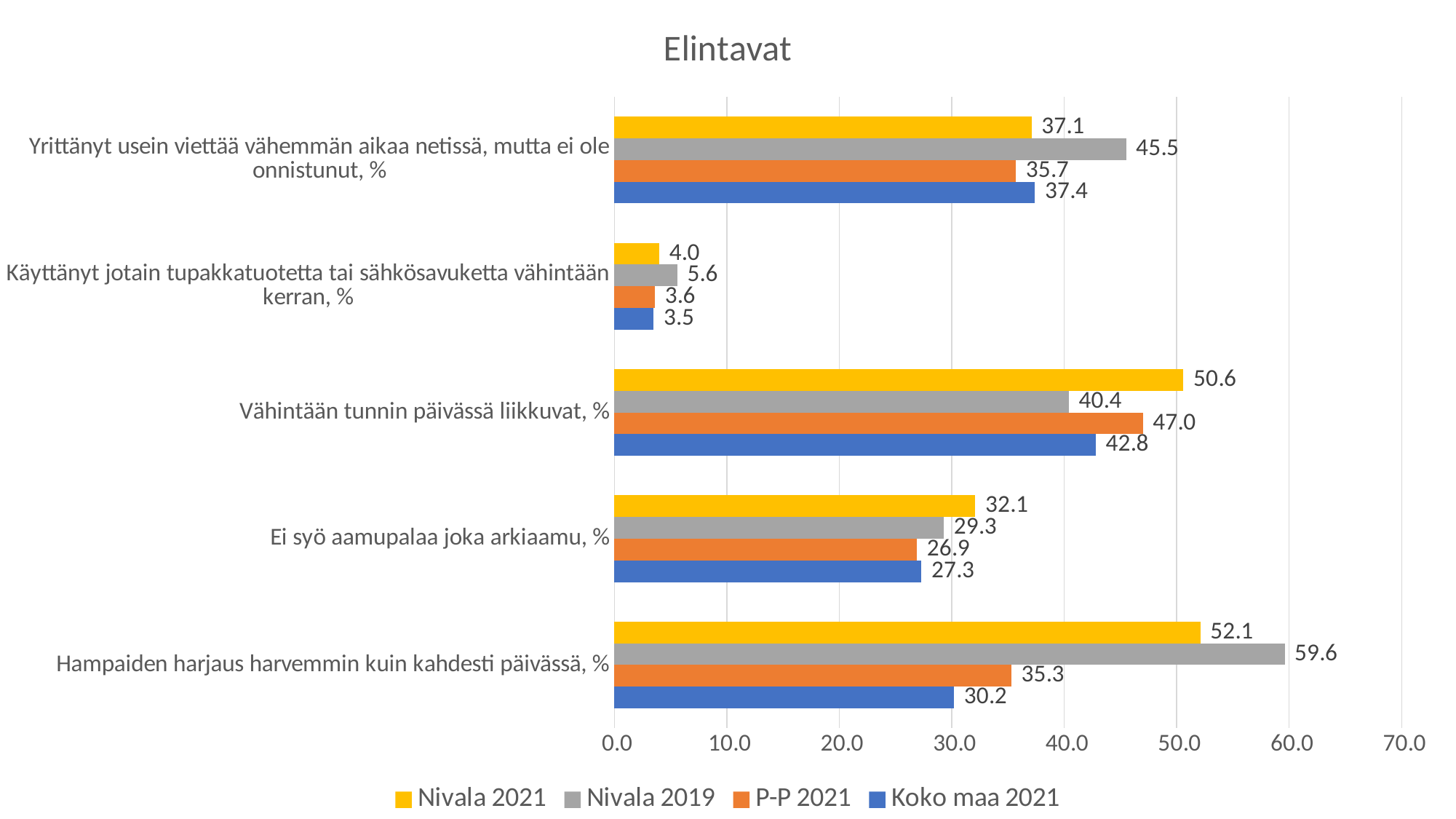
How many categories are shown on the chart? 5 What is the title of the chart? Elintavat Which series has the highest value for 'Hampaiden harjaus harvemmin kuin kahdesti päivässä, %'? Nivala 2019 What is the value for P-P 2021 for 'Ei syö aamupalaa joka arkiaamu, %'? 26.9 Which series has the lowest value for 'Käyttänyt jotain tupakkatuotetta tai sähkösavuketta vähintään kerran, %'? Koko maa 2021 How many series does the legend list? 4 What is the value for Nivala 2021 for 'Hampaiden harjaus harvemmin kuin kahdesti päivässä, %'? 52.1 Which is larger for 'Vähintään tunnin päivässä liikkuvat, %': Nivala 2021 or Nivala 2019? Nivala 2021 What kind of chart is this? Bar chart What is the difference between Nivala 2019 and Koko maa 2021 for 'Hampaiden harjaus harvemmin kuin kahdesti päivässä, %'? 29.4 What is the value for Koko maa 2021 for 'Vähintään tunnin päivässä liikkuvat, %'? 42.8 What is the value for Nivala 2019 for 'Yrittänyt usein viettää vähemmän aikaa netissä, mutta ei ole onnistunut, %'? 45.5